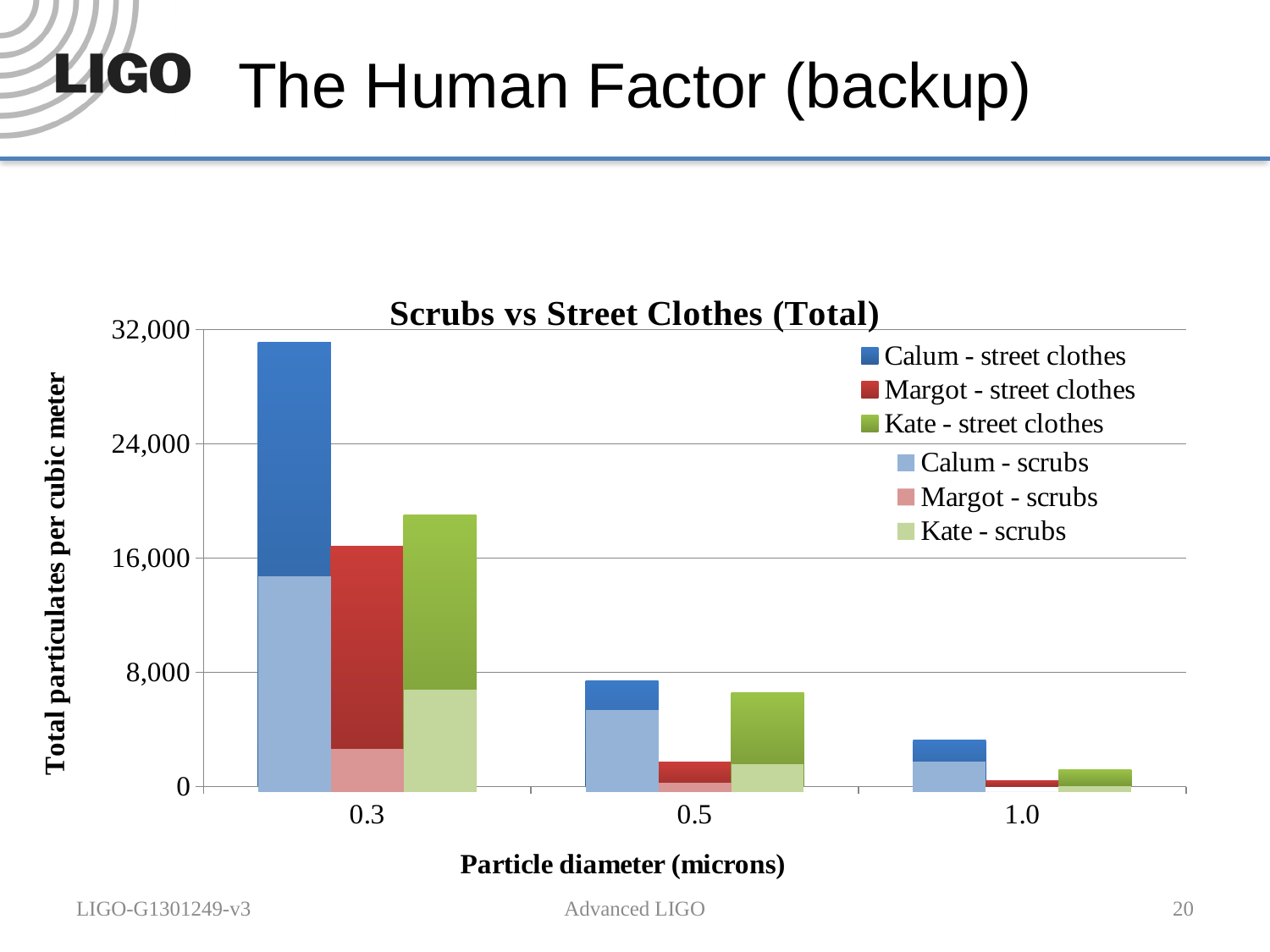
At 0.5 microns, whose total bar is taller, Kate's or Margot's? Kate How many particle diameter categories are shown on the x axis? 3 What is the title of the chart? Scrubs vs Street Clothes (Total) What is the label of the x axis? Particle diameter (microns) Is the total value for Kate at 0.5 microns greater or less than 8,000? less How many series does the legend list? 6 At 1.0 microns, which person has the lowest total bar? Margot At 0.3 microns, whose total bar is taller, Calum's or Margot's? Calum What kind of chart is shown on the slide? Stacked bar chart At which particle diameter is Calum's total bar the tallest? 0.3 Is the total value for Margot at 0.3 microns greater or less than 8,000? greater Is the total value for Calum at 0.3 microns greater or less than 24,000? greater